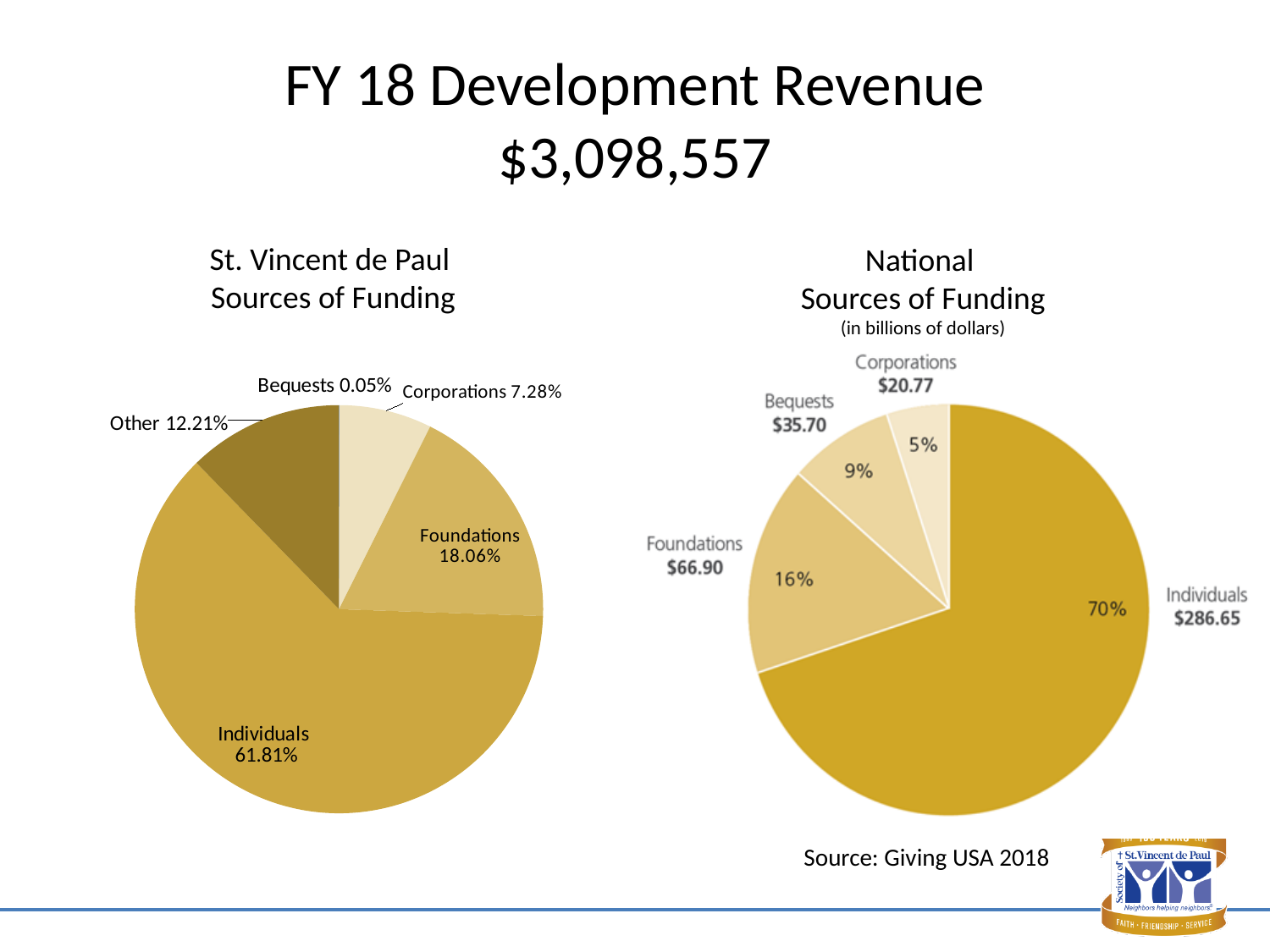
In the St. Vincent de Paul Sources of Funding chart, what share of funding comes from Foundations? 18.06% In the National Sources of Funding chart, what is the value for Bequests? $35.70 What kind of chart is the St. Vincent de Paul Sources of Funding chart? pie chart In the National Sources of Funding chart, what is the value for Individuals? $286.65 In the St. Vincent de Paul Sources of Funding chart, what is the difference between the Foundations share and the Other share? 5.85% In the National Sources of Funding chart, what is the difference between the Foundations value and the Corporations value? $46.13 In the St. Vincent de Paul Sources of Funding chart, which source has the smallest share? Bequests In the St. Vincent de Paul Sources of Funding chart, how many slices does the pie have? 5 In the St. Vincent de Paul Sources of Funding chart, which is larger: Other or Corporations? Other In the National Sources of Funding chart, what percentage share do Foundations have? 16% In the St. Vincent de Paul Sources of Funding chart, what share of funding comes from Individuals? 61.81% In the National Sources of Funding chart, which source has the largest value? Individuals